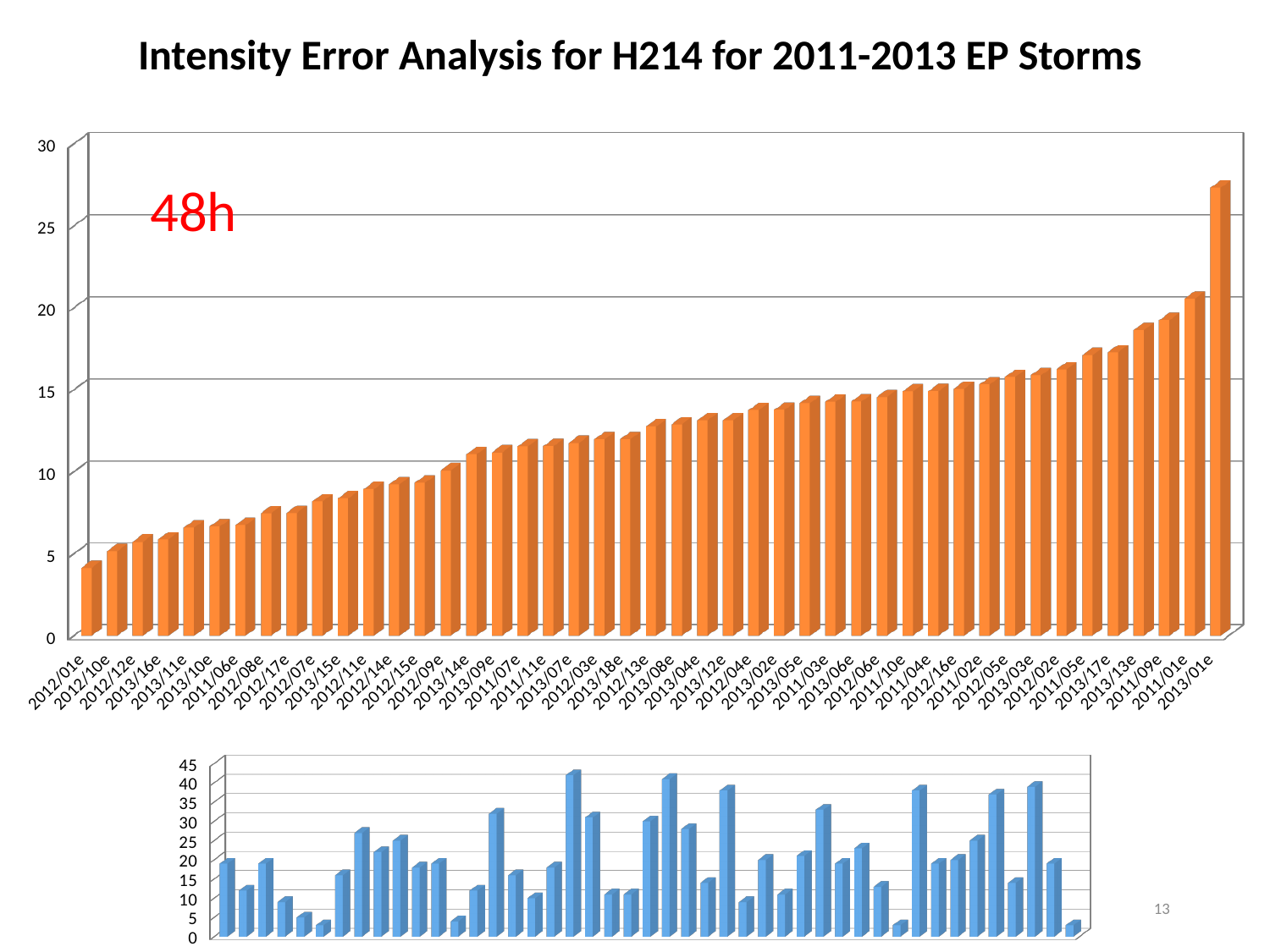
In the top chart, is the value for 2012/17e greater or less than 10? less In the top chart, which storm has the lowest intensity error? 2012/01e In the top chart, which is larger, the value for 2013/01e or the value for 2011/01e? 2013/01e What red text annotation appears inside the top chart? 48h In the top chart, is the value for 2013/13e greater or less than 15? greater What is the title of the slide's top chart? Intensity Error Analysis for H214 for 2011-2013 EP Storms In the top chart, is the value for 2013/01e greater or less than 25? greater In the top chart, which storm has the highest intensity error? 2013/01e In the top chart, what kind of chart is shown? bar chart In the top chart, do the values rise or fall from left to right along the x axis? rise